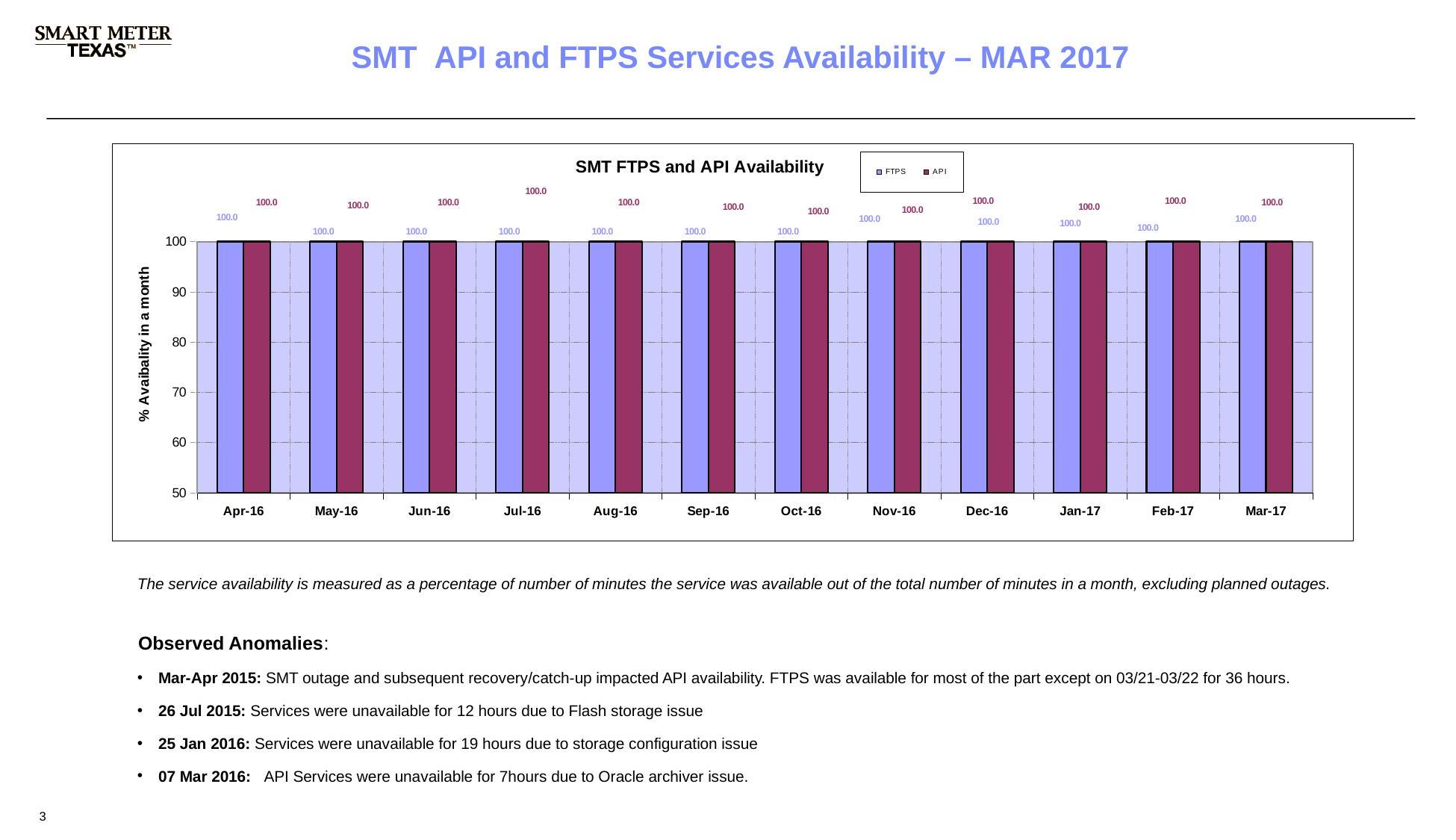
What is the FTPS availability value for Apr-16? 100.0 What is the FTPS availability value for Oct-16? 100.0 How many series does the chart legend list? 2 What is the difference between the FTPS and API availability values for Dec-16? 0.0 Do the FTPS availability values rise, fall, or stay flat from Apr-16 to Mar-17? Stay flat What kind of chart is shown on the slide? Bar chart What is the title of the chart? SMT FTPS and API Availability Is the API availability value for Sep-16 greater or less than 90? greater How many months are shown on the x axis of the chart? 12 What is the API availability value for Jul-16? 100.0 What is the label on the y axis of the chart? % Avaibality in a month What is the API availability value for Mar-17? 100.0